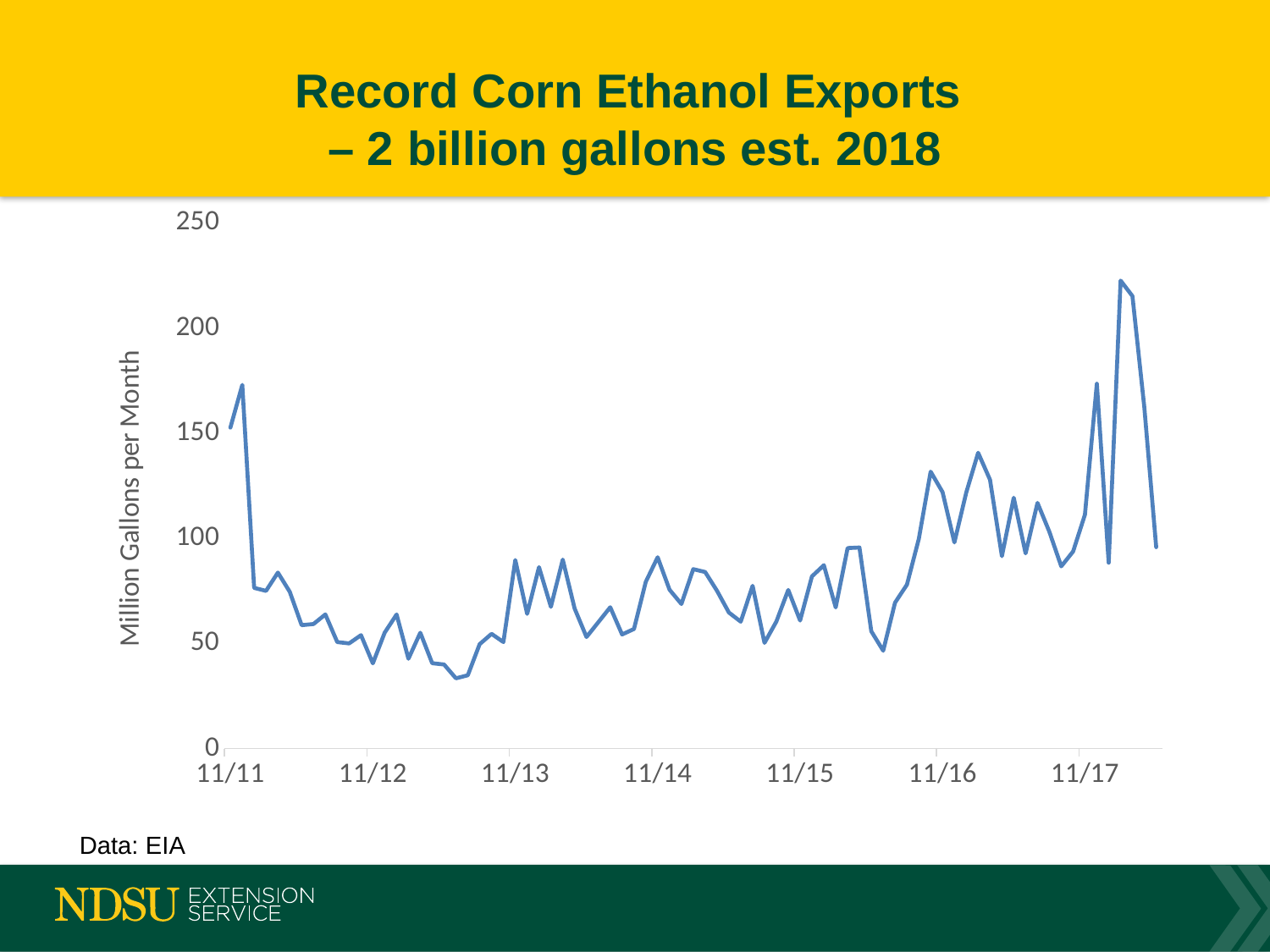
What is the label on the vertical axis of the chart? Million Gallons per Month Is the value at 11/11 greater or less than 100? greater Is the highest peak on the chart greater or less than 200? greater Do the values generally rise or fall between 11/15 and 11/17? rise What is the title of the chart on the slide? Record Corn Ethanol Exports – 2 billion gallons est. 2018 Is the lowest point on the chart greater or less than 50? less Do the values rise or fall between 11/11 and 11/12? fall How many lines (series) are plotted on the chart? 1 What kind of chart is shown on the slide? line chart How many date labels are shown along the x axis of the chart? 7